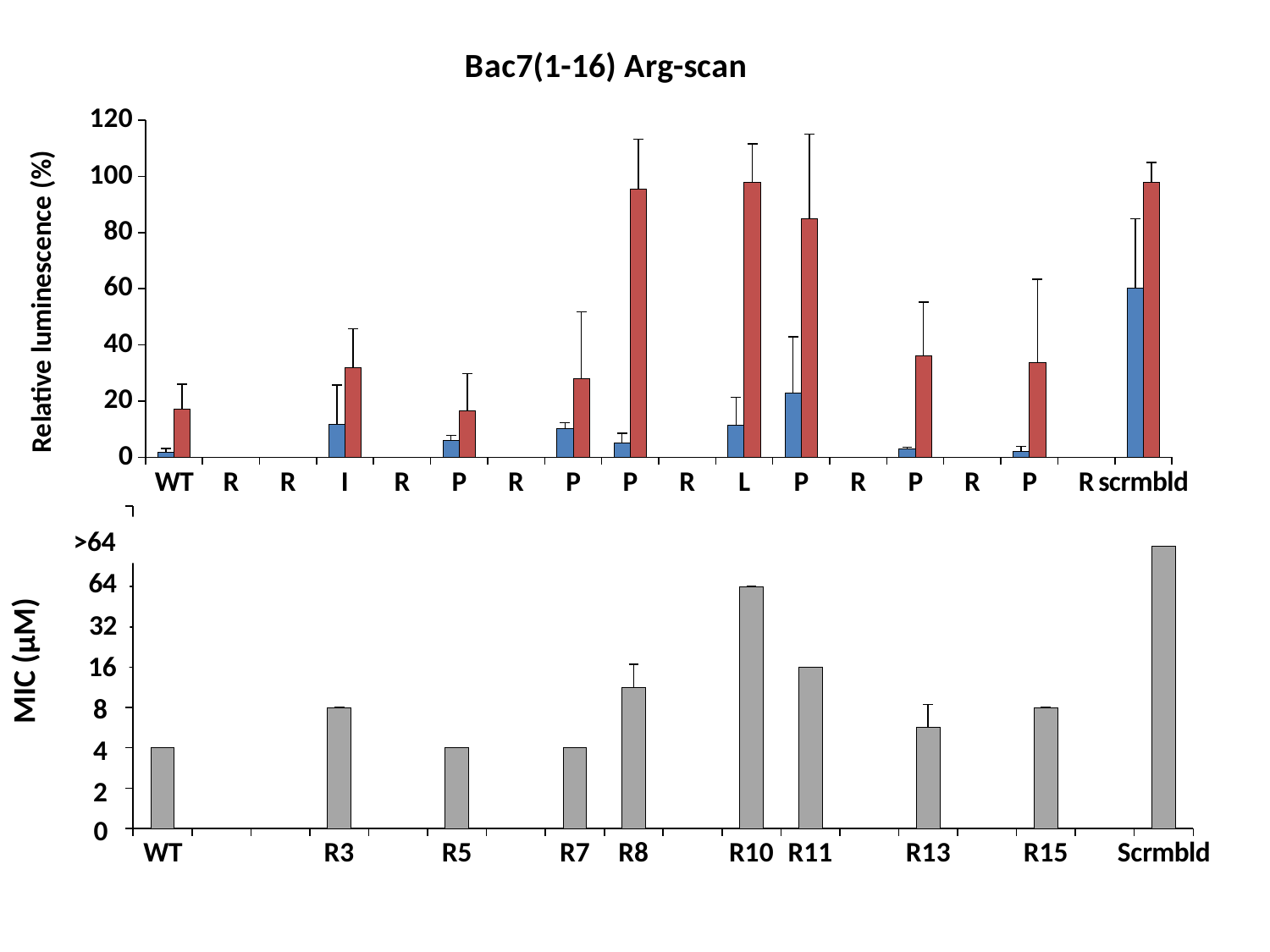
In the top chart (Bac7(1-16) Arg-scan), is the red bar for scrmbld greater or less than 80? greater In the top chart (Bac7(1-16) Arg-scan), is the red bar for WT greater or less than 20? less What is the y-axis label of the bottom chart? MIC (µM) In the bottom chart (MIC), what is the MIC value for WT? 4 In the bottom chart (MIC), what is the difference between the MIC of R10 and R11? 48 In the bottom chart (MIC), what is the MIC value for R3? 8 What kind of chart is the top chart (Bac7(1-16) Arg-scan)? bar chart In the bottom chart (MIC), what is the MIC value for R10? 64 In the bottom chart (MIC), which category has the highest MIC? Scrmbld In the bottom chart (MIC), what is the MIC value for R11? 16 In the bottom chart (MIC), which has the larger MIC, R10 or R11? R10 In the bottom chart (MIC), how many labeled categories are shown on the x axis? 10